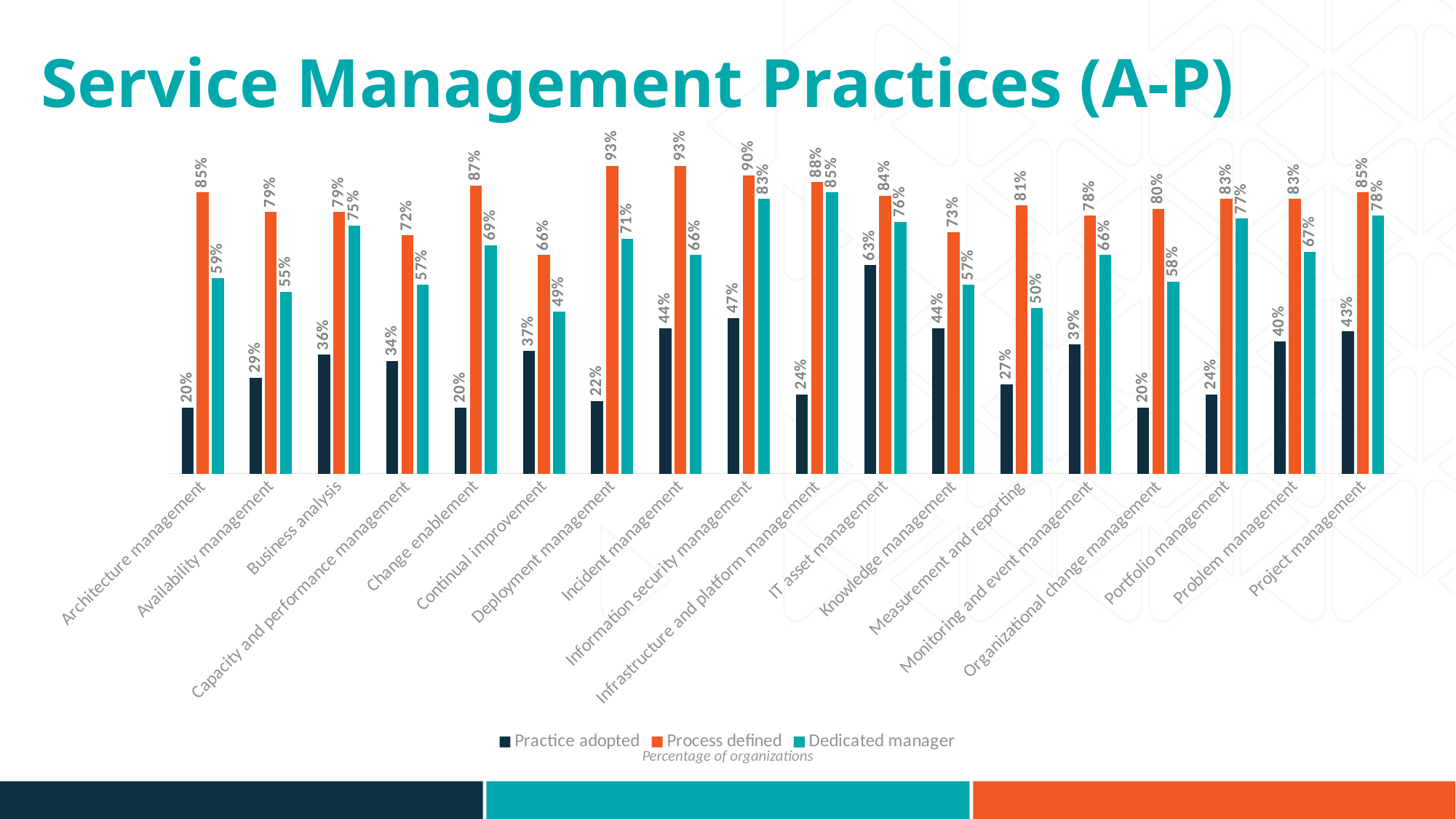
Which practice has the highest Practice adopted value? IT asset management What kind of chart is shown on the slide? Bar chart Which practice has the lowest Process defined value? Continual improvement How many series does the legend list? 3 What is the title of the slide? Service Management Practices (A-P) Which is larger for Business analysis: the Process defined value or the Dedicated manager value? Process defined What is the difference between the Process defined and Practice adopted values for Architecture management? 65% What is the Process defined value for Deployment management? 93% What is the Dedicated manager value for Continual improvement? 49% What is the Practice adopted value for IT asset management? 63% How many practices are shown on the x axis? 18 Which practice has the lowest Dedicated manager value? Continual improvement